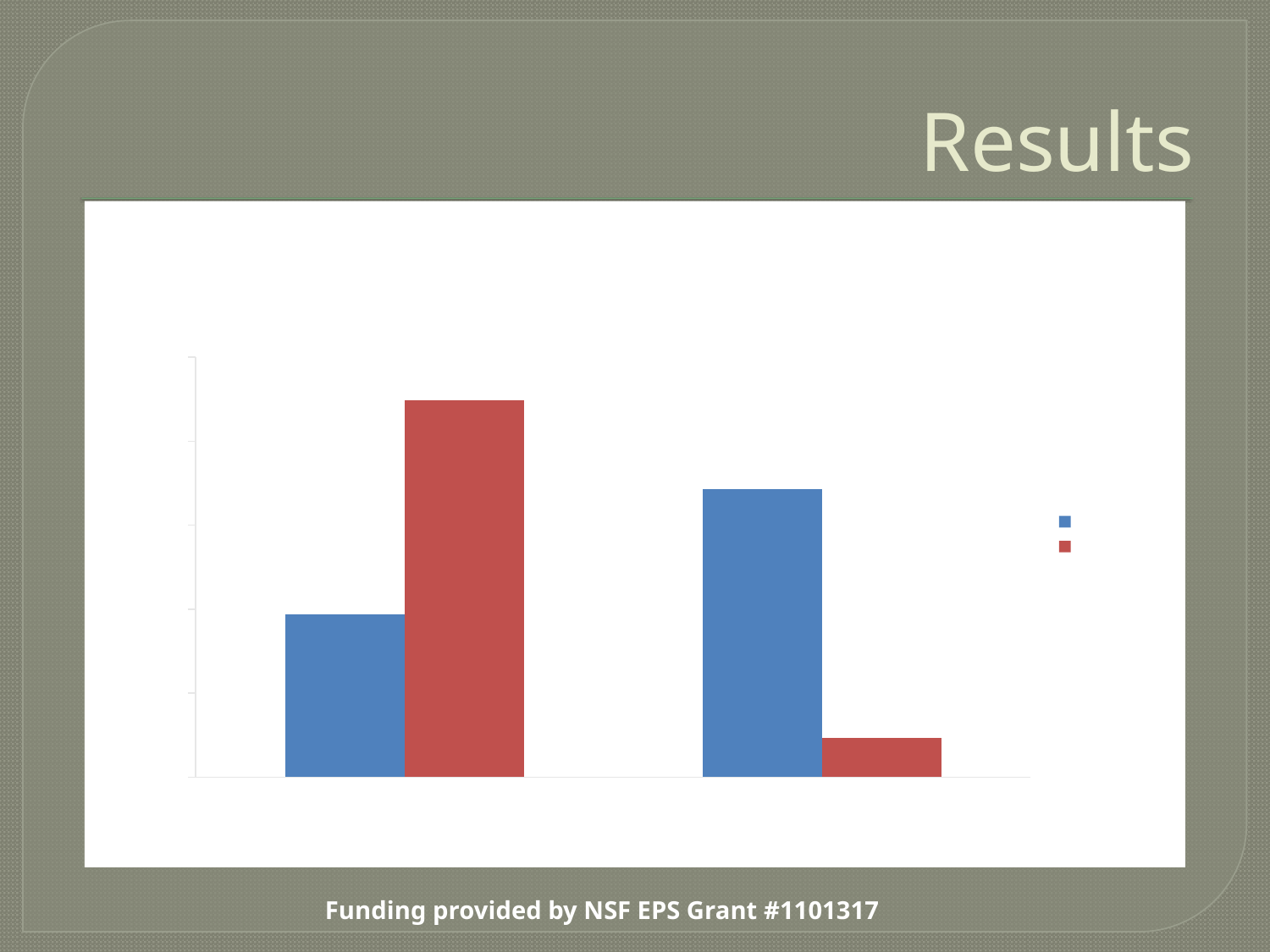
Are the bars on the chart vertical or horizontal? vertical How many groups of bars (categories) are plotted on the chart? 2 In the left group of bars, which bar is taller, the blue one or the red one? the red one Which bar is the shortest on the chart? the red bar in the right group Does the blue series rise or fall from the left group to the right group? rise Which bar is the tallest on the chart? the red bar in the left group What two colours are used for the bars on the chart? blue and red How many series does the chart's legend list? 2 What kind of chart is shown on the slide? bar chart In the right group of bars, which bar is taller, the blue one or the red one? the blue one Does the red series rise or fall from the left group to the right group? fall